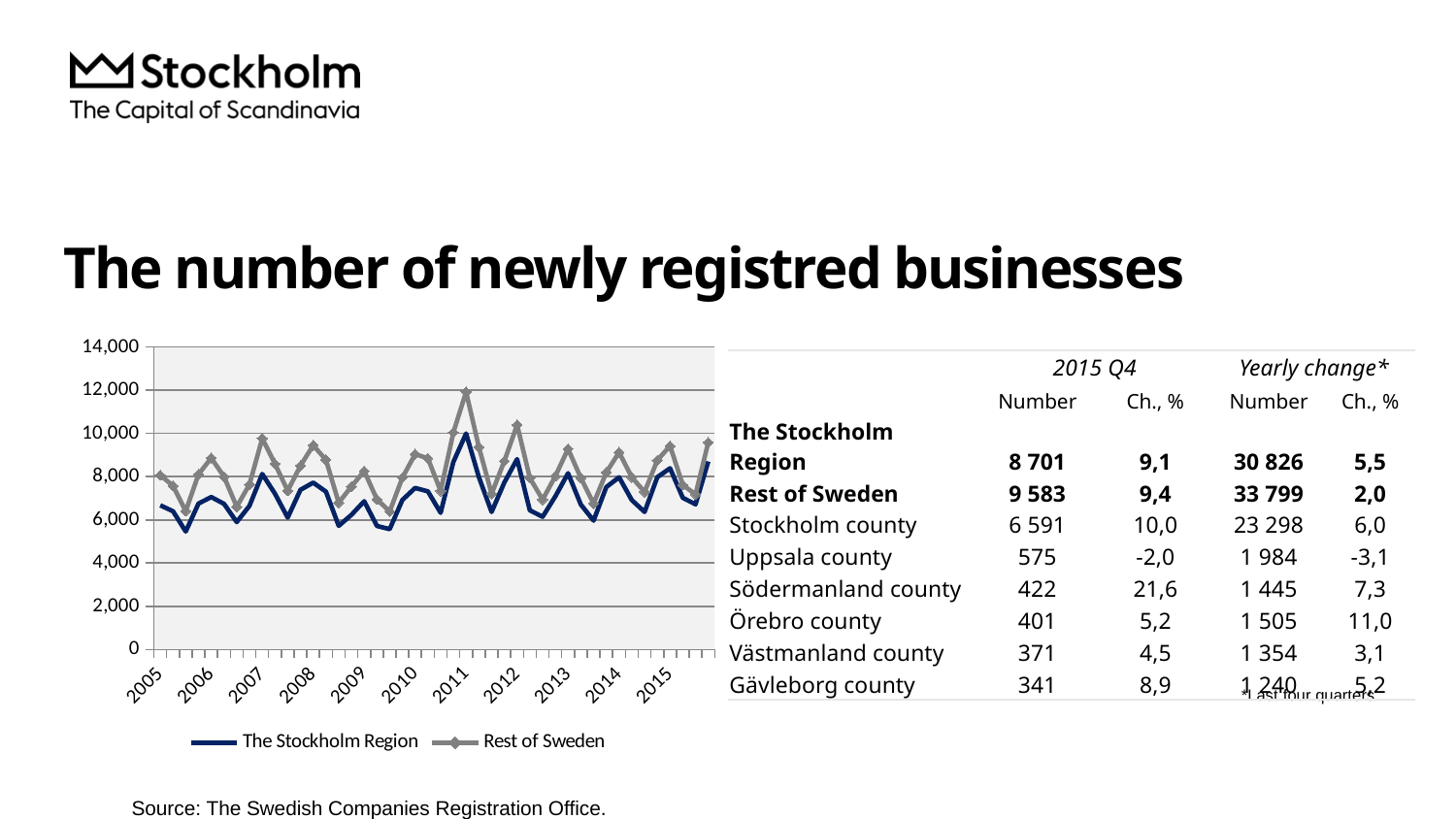
Which series generally has higher values throughout the chart, The Stockholm Region or Rest of Sweden? Rest of Sweden How many series does the chart's legend list? 2 What is the highest value shown on the chart's vertical axis? 14,000 What kind of chart is shown on the slide? Line chart In which year does the Rest of Sweden series reach its highest peak? 2011 Do the values for The Stockholm Region generally rise or fall from 2005 to 2015? rise Which series is plotted with the dark blue line in the chart? The Stockholm Region Is the first value for Rest of Sweden in 2005 greater or less than 6,000? greater Is the highest value for Rest of Sweden in 2011 greater or less than 10,000? greater Is the highest value for The Stockholm Region greater or less than 12,000? less What are the two series named in the chart's legend? The Stockholm Region and Rest of Sweden